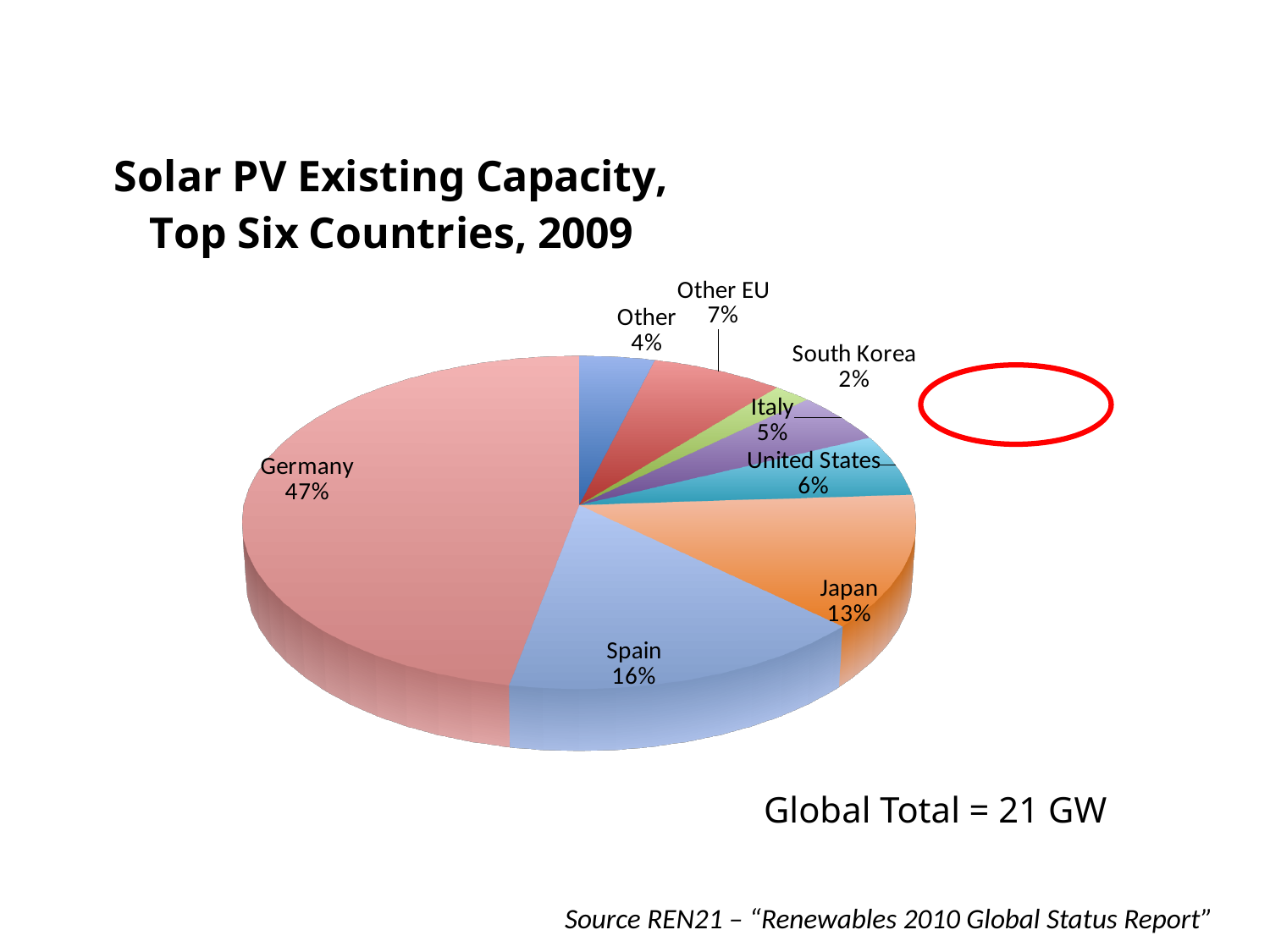
Which is larger, the share for Other EU or the share for Italy? Other EU How many slices does the pie chart have? 8 What is the value for Japan? 13% What percentage is shown for Spain? 16% What share of the pie does Germany hold? 47% What is the title of the chart? Solar PV Existing Capacity, Top Six Countries, 2009 Which category has the smallest slice of the pie? South Korea What global total is stated on the slide? 21 GW Which category has the largest slice of the pie? Germany What percentage is shown for the United States? 6% What kind of chart is shown on the slide? Pie chart What is the difference in percentage points between Germany and Spain? 31